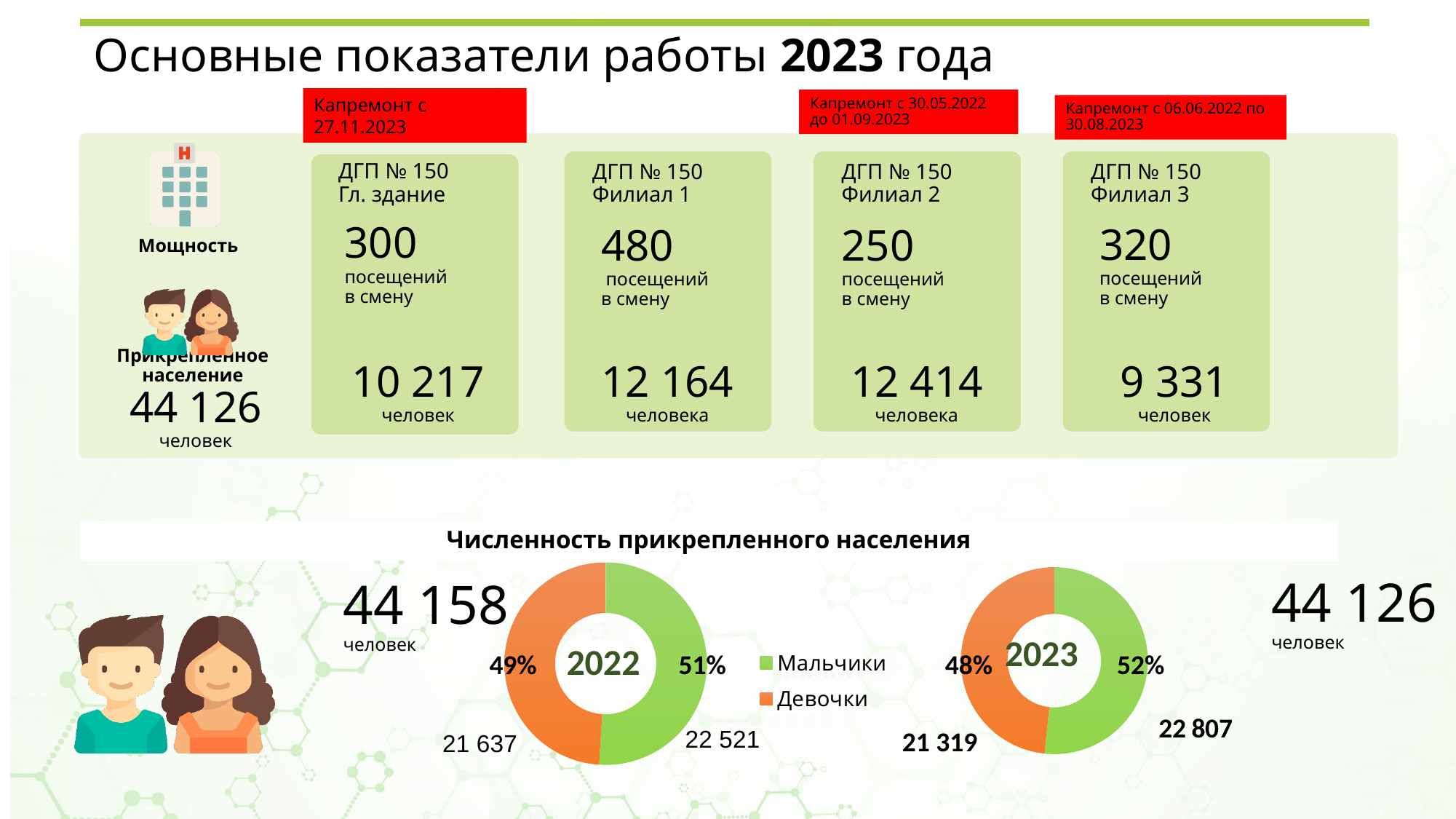
In the 2023 chart, what is the number of Мальчики? 22 807 In the 2023 chart, which group is larger, Мальчики or Девочки? Мальчики In the 2022 chart, what share of the population is Мальчики? 51% In the 2022 chart, what is the number of Девочки? 21 637 How many series does the legend of the population charts list? 2 In the 2023 chart, what is the number of Девочки? 21 319 In the 2023 chart, what share of the population is Мальчики? 52% In the 2022 chart, what is the number of Мальчики? 22 521 In the 2022 chart, what share of the population is Девочки? 49% What type of chart is used to show the 2022 population breakdown? Donut (pie) chart In the 2023 chart, what is the difference between the number of Мальчики and Девочки? 1 488